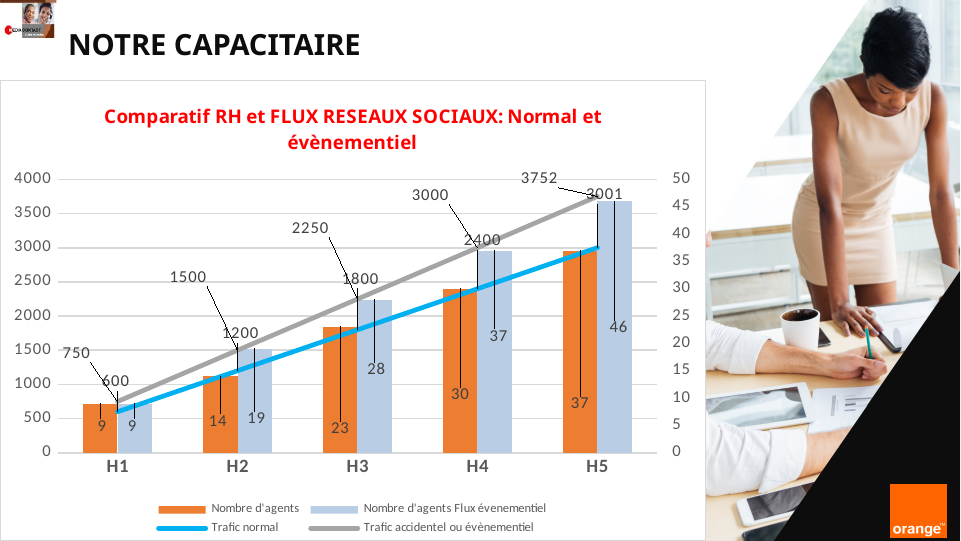
How many categories are shown on the x axis? 5 What is the value of Trafic normal for H2? 1200 Do the values for Trafic normal rise or fall from H1 to H5? rise Which category has the lowest value for Trafic accidentel ou évènementiel? H1 What is the value of Trafic accidentel ou évènementiel for H5? 3752 Which category has the highest value for Nombre d'agents? H5 What is the value of Nombre d'agents Flux évenementiel for H5? 46 How many series does the legend list? 4 What is the title of the chart? Comparatif RH et FLUX RESEAUX SOCIAUX: Normal et évènementiel What is the difference between Nombre d'agents Flux évenementiel and Nombre d'agents for H4? 7 What is the value of Nombre d'agents for H3? 23 Which is larger for H3: Trafic normal or Trafic accidentel ou évènementiel? Trafic accidentel ou évènementiel